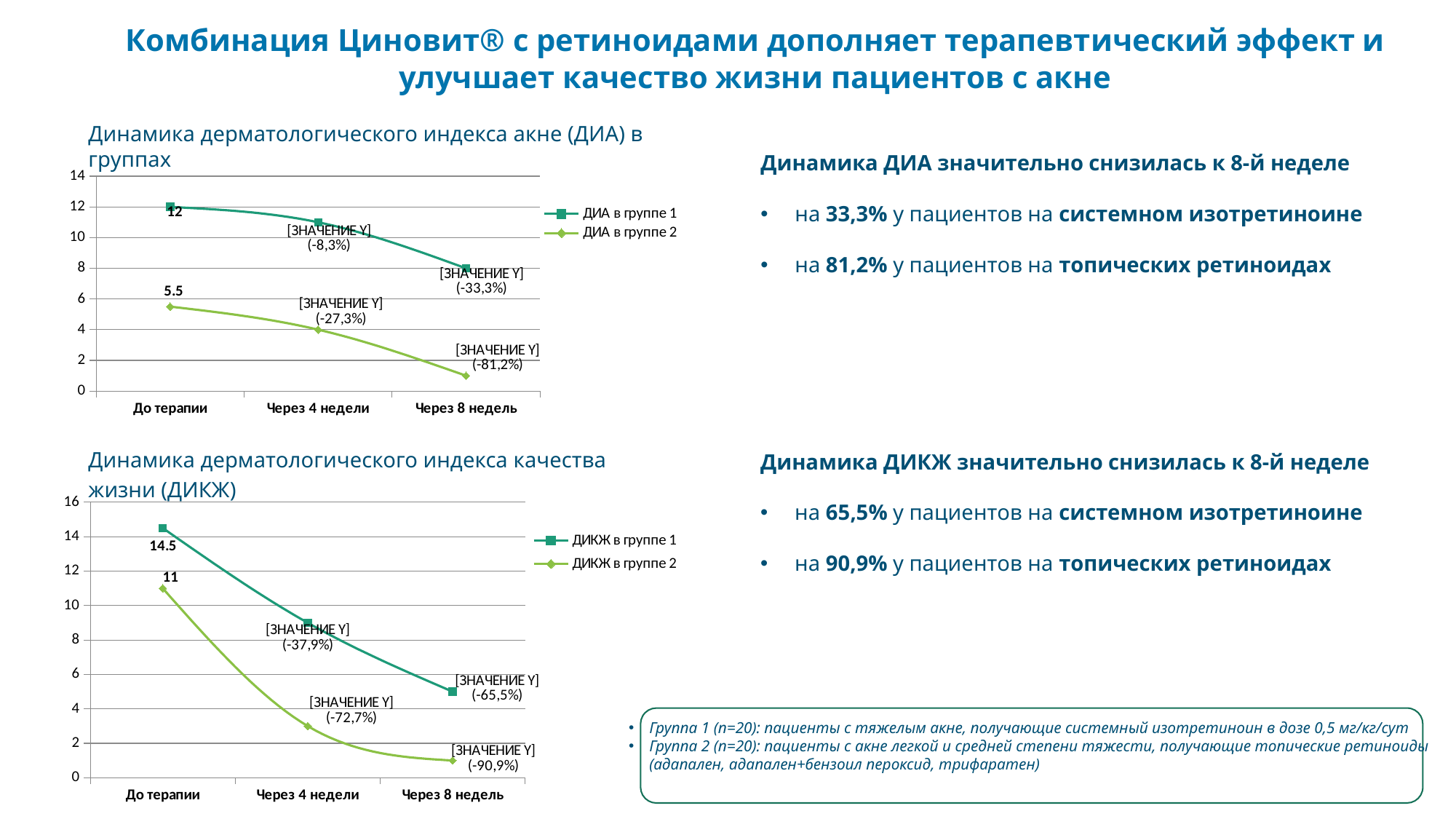
On the top chart (ДИА), how many series does the legend list? 2 On the bottom chart (Динамика дерматологического индекса качества жизни (ДИКЖ)), what is the value for ДИКЖ в группе 1 at До терапии? 14.5 On the bottom chart (ДИКЖ), what is the difference between the До терапии values of ДИКЖ в группе 1 and ДИКЖ в группе 2? 3.5 What kind of chart is the bottom chart (ДИКЖ)? line chart On the bottom chart (ДИКЖ), is the value for ДИКЖ в группе 1 at Через 8 недель greater or less than 4? greater On the bottom chart (ДИКЖ), what is the value for ДИКЖ в группе 2 at До терапии? 11 On the top chart (Динамика дерматологического индекса акне (ДИА) в группах), what is the value for ДИА в группе 1 at До терапии? 12 On the top chart (ДИА), what percentage change is labelled for ДИА в группе 1 at Через 8 недель? -33,3% On the top chart (ДИА), what is the value for ДИА в группе 2 at До терапии? 5.5 On the top chart (ДИА), is the value for ДИА в группе 2 at Через 8 недель greater or less than 2? less On the top chart (ДИА), do the values for ДИА в группе 1 rise or fall from До терапии to Через 8 недель? fall On the top chart (ДИА), what percentage change is labelled for ДИА в группе 2 at Через 4 недели? -27,3%